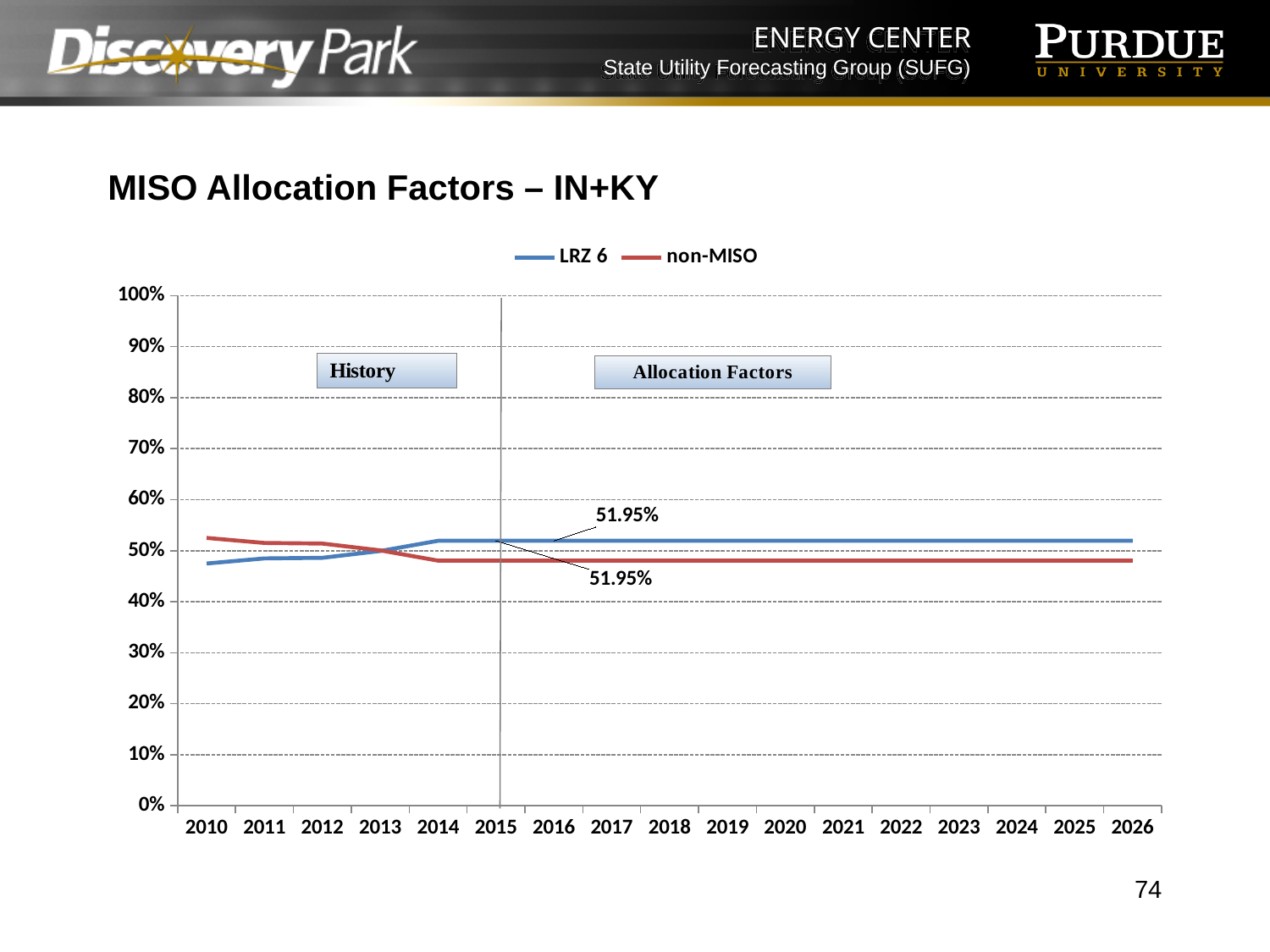
Does the LRZ 6 line rise or fall from 2010 to 2014? rise What kind of chart is shown on the slide? line chart In 2010, which series has the higher value, LRZ 6 or non-MISO? non-MISO What is the title of the chart on the slide? MISO Allocation Factors – IN+KY Is the value for non-MISO in 2010 greater or less than 50%? greater Does the non-MISO line rise or fall from 2010 to 2014? fall What value is labelled on the LRZ 6 line at 2015? 51.95% What are the two series named in the legend? LRZ 6 and non-MISO Is the value for LRZ 6 in 2010 greater or less than 50%? less How many series does the legend list? 2 How many years are shown along the x axis? 17 In 2026, which series has the higher value, LRZ 6 or non-MISO? LRZ 6